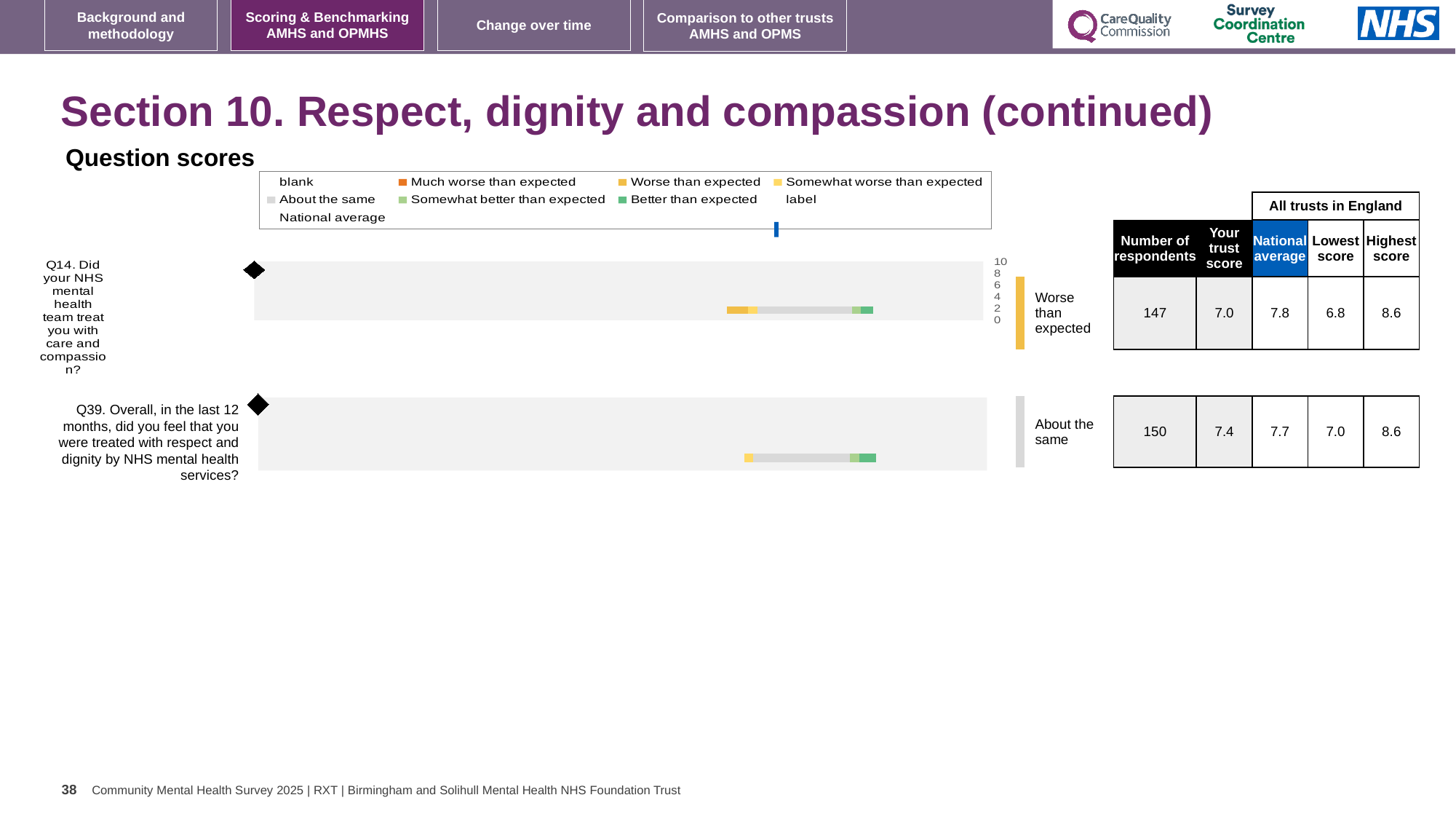
In the table beside the chart, what is the lowest score for Q14? 6.8 In the table beside the chart, what is the national average for Q14? 7.8 In the table beside the chart, what is your trust score for Q39? 7.4 What category label is shown next to the Q39 bar in the question scores chart? About the same What category label is shown next to the Q14 bar in the question scores chart? Worse than expected In the table beside the chart, what is the number of respondents for Q14? 147 How many questions are plotted in the question scores chart? 2 What kind of chart is used to show the question scores on this slide? bar chart Which legend entry in the question scores chart is shown in orange? Much worse than expected How many entries does the legend of the question scores chart list? 9 In the table beside the chart, which question has the higher trust score, Q14 or Q39? Q39 In the table beside the chart, what is the difference between the highest score and the lowest score for Q39? 1.6